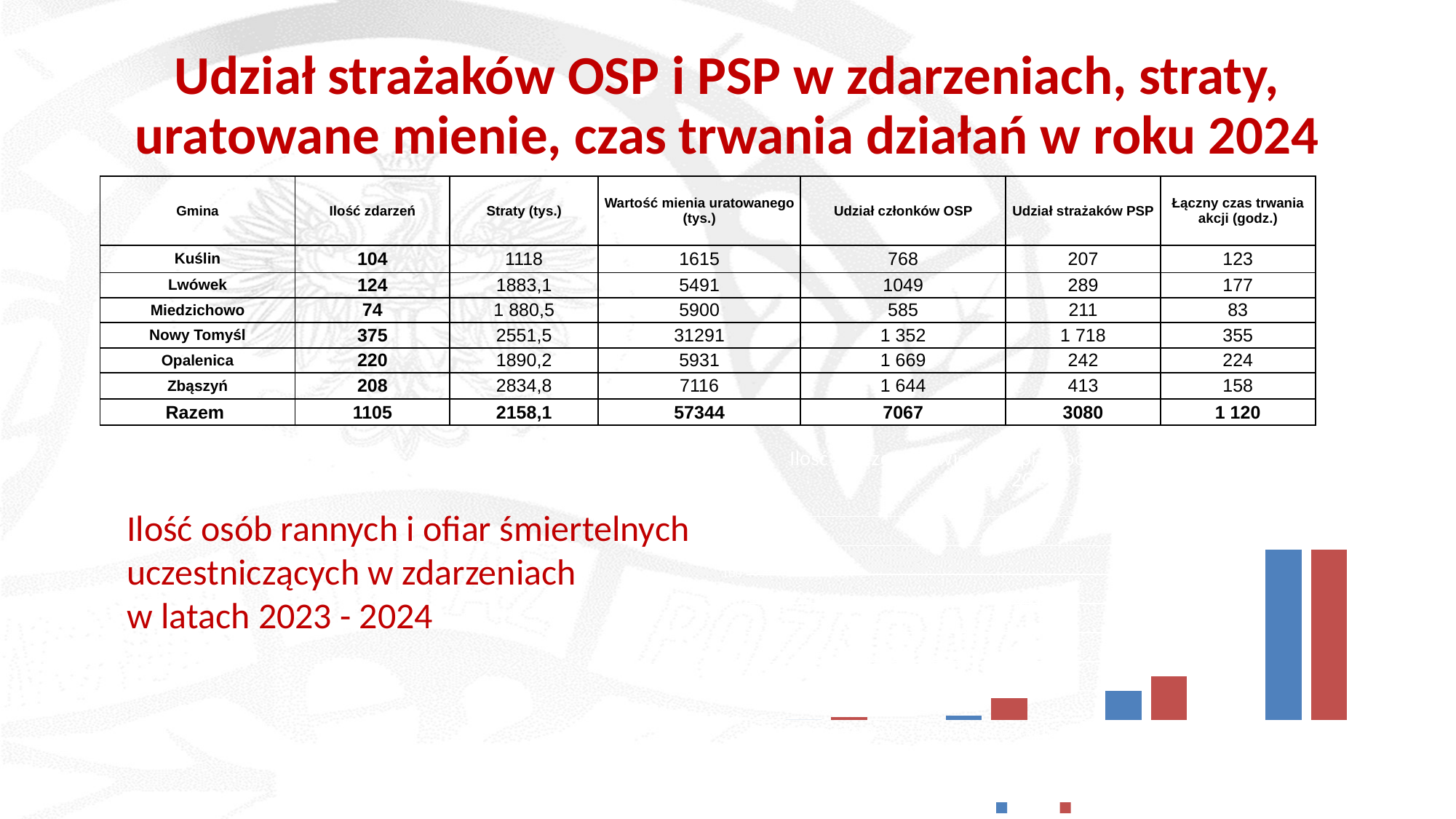
How many series does the legend of the bar chart list? 2 What two colours are used for the bars in the bar chart? blue and red Do the bar heights in the bar chart rise or fall from left to right? rise In the third group of bars from the left in the bar chart, is the blue bar or the red bar taller? red How many groups of bars are plotted in the bar chart? 4 Which group of bars in the bar chart has the tallest bars, the leftmost or the rightmost? rightmost What kind of chart is shown at the bottom right of the slide? bar chart